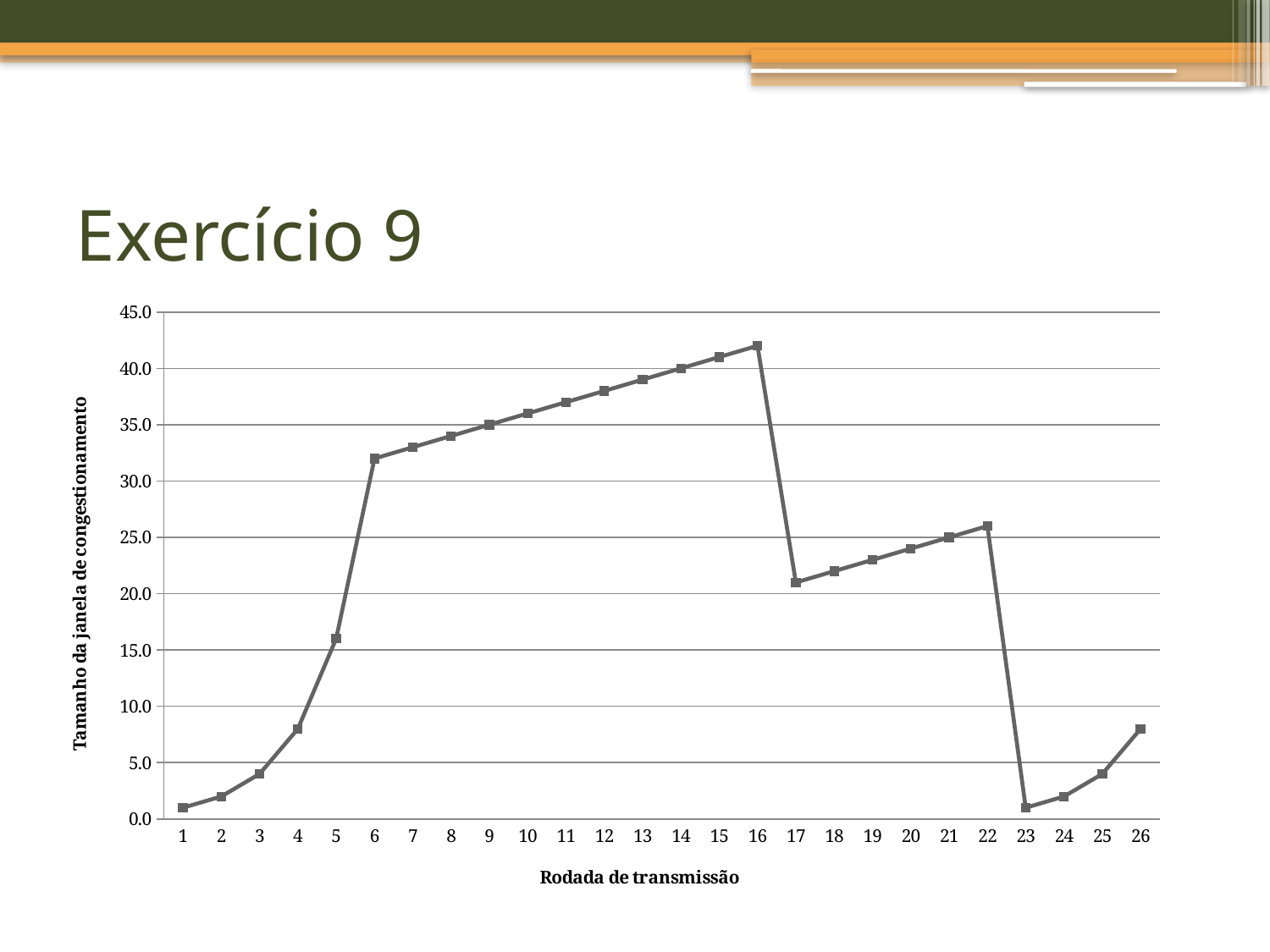
Is the value at transmission round 6 greater or less than 30? greater At which transmission round does the congestion window size reach its highest value? 16 How many transmission rounds (points) are plotted along the x axis? 26 What kind of chart is shown on the slide? line chart What is the title of the x axis? Rodada de transmissão What is the congestion window size at transmission round 9? 35.0 What is the congestion window size at transmission round 14? 40.0 Is the value at transmission round 23 greater or less than 5? less Which has a larger congestion window size, transmission round 16 or transmission round 22? 16 Does the congestion window size rise or fall between transmission rounds 6 and 16? rise Is the value at transmission round 12 greater or less than 35? greater What is the congestion window size at transmission round 21? 25.0